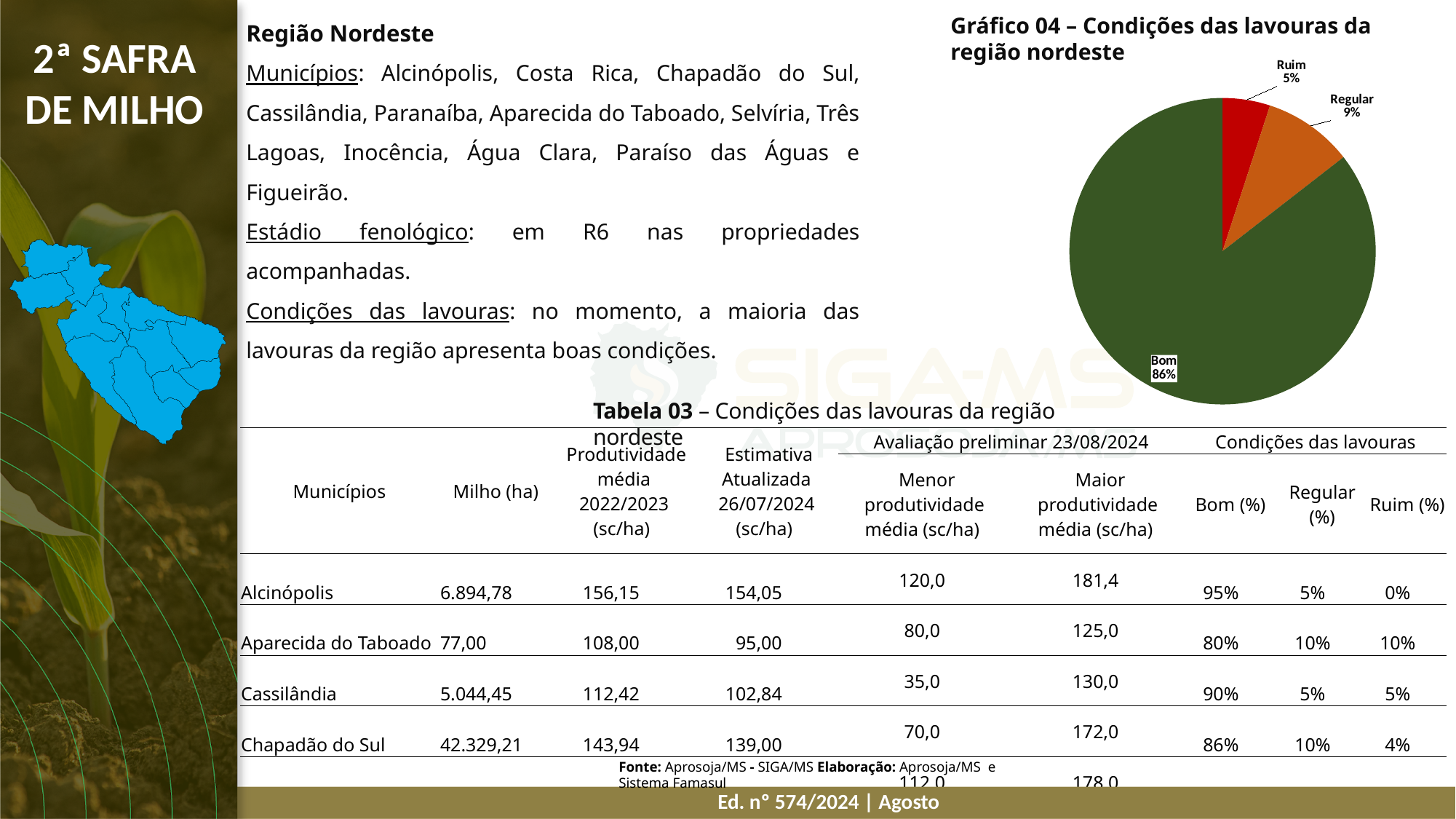
What is the value shown for 'Regular' in the pie chart? 9% What is the difference in percentage points between the 'Bom' and 'Regular' slices? 77 How many categories are shown in the pie chart? 3 What share of the pie chart does the 'Bom' slice represent? 86% What is the title of the chart on the slide? Gráfico 04 – Condições das lavouras da região nordeste Which category has the smallest slice in the pie chart? Ruim What type of chart is Gráfico 04? Pie chart What is the difference in percentage points between the 'Regular' and 'Ruim' slices? 4 What colour is the 'Bom' slice in the pie chart? Dark green What is the value shown for 'Ruim' in the pie chart? 5% Which category has the largest slice in the pie chart? Bom Which slice is larger, 'Regular' or 'Ruim'? Regular